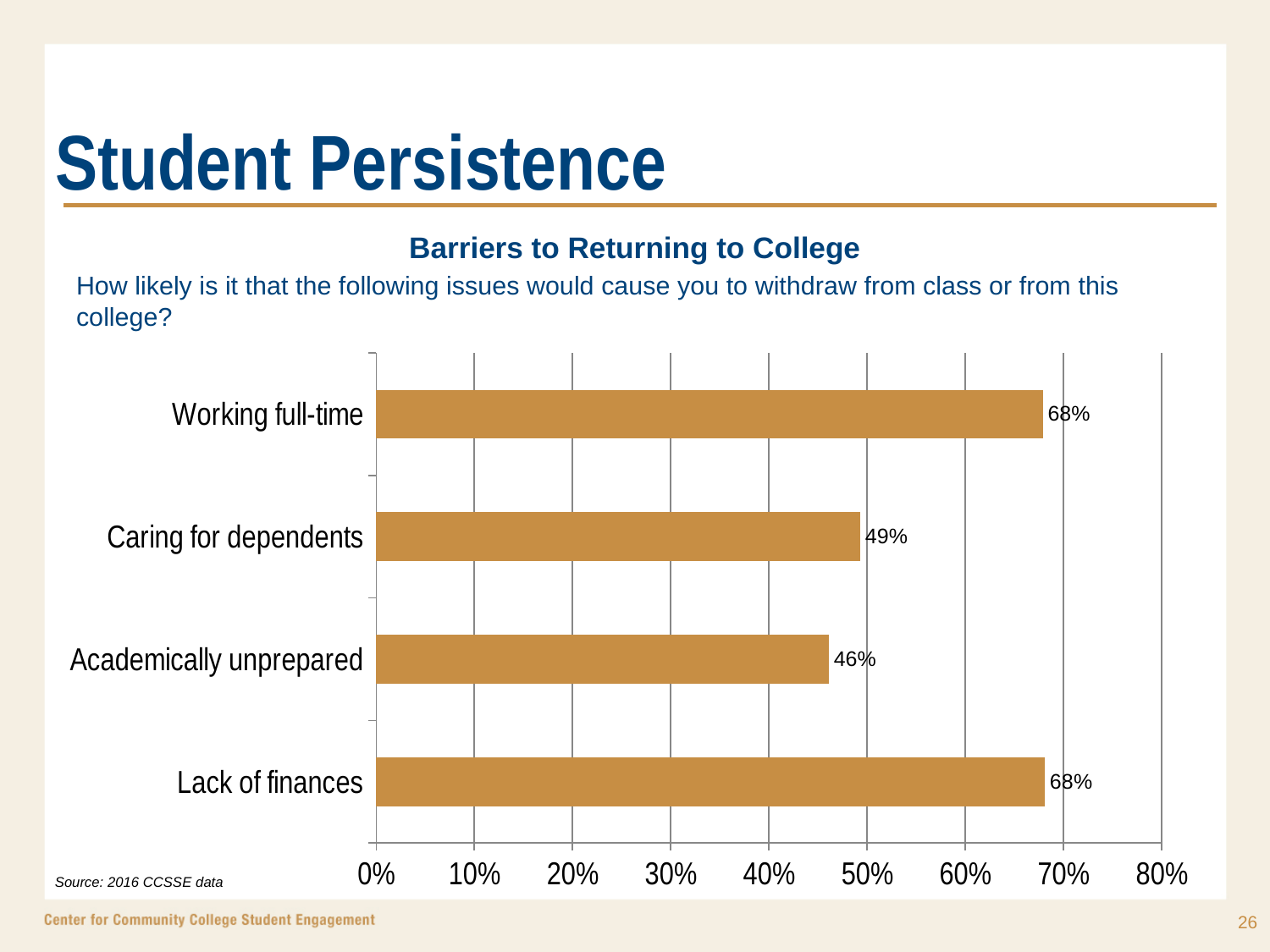
How many categories are shown in the chart? 4 What is the value for Lack of finances? 68% What is the title of the chart? Barriers to Returning to College Which category has the lowest value? Academically unprepared What is the difference between the values for Caring for dependents and Academically unprepared? 3% What is the value for Caring for dependents? 49% Is the value for Caring for dependents greater or less than 40%? greater What is the value for Academically unprepared? 46% What is the difference between the values for Working full-time and Caring for dependents? 19% What is the value for Working full-time? 68% Which is larger, the value for Lack of finances or the value for Academically unprepared? Lack of finances What kind of chart is shown on the slide? Bar chart